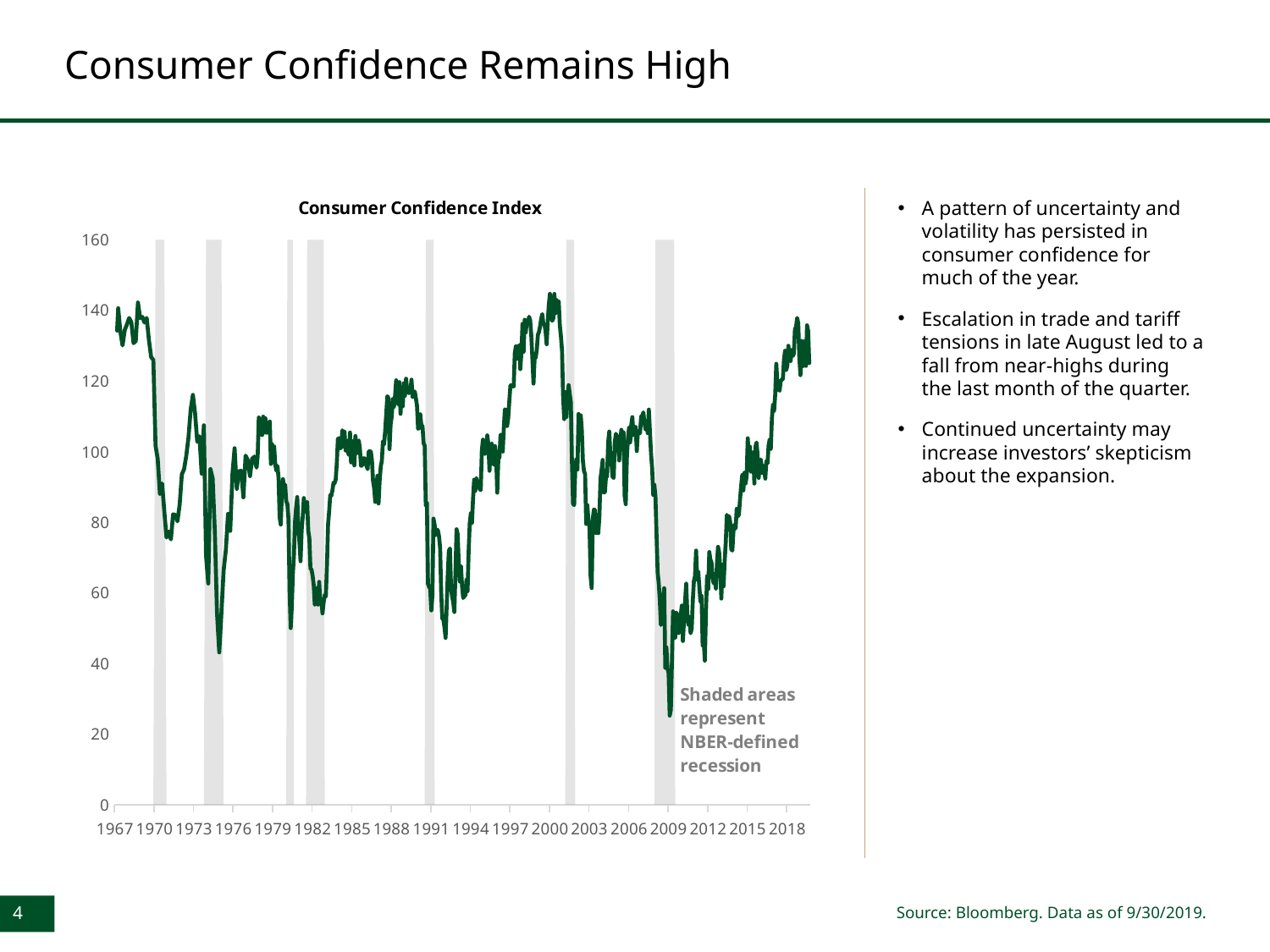
Does the Consumer Confidence Index generally rise or fall between 2000 and 2003? fall What kind of chart is shown on the slide? line chart What is the title of the chart? Consumer Confidence Index How many shaded recession areas are shown on the chart? 7 Is the lowest value of the Consumer Confidence Index around 2009 greater or less than 40? less Which is higher on the chart: the peak around 2000 or the peak around 2007? the peak around 2000 Is the peak value of the Consumer Confidence Index around 2000 greater or less than 140? greater Is the value of the Consumer Confidence Index at the start of the series in 1967 greater or less than 120? greater Does the Consumer Confidence Index generally rise or fall between 2009 and 2018? rise What is the highest value shown on the y axis of the chart? 160 According to the chart annotation, what do the shaded areas represent? NBER-defined recession